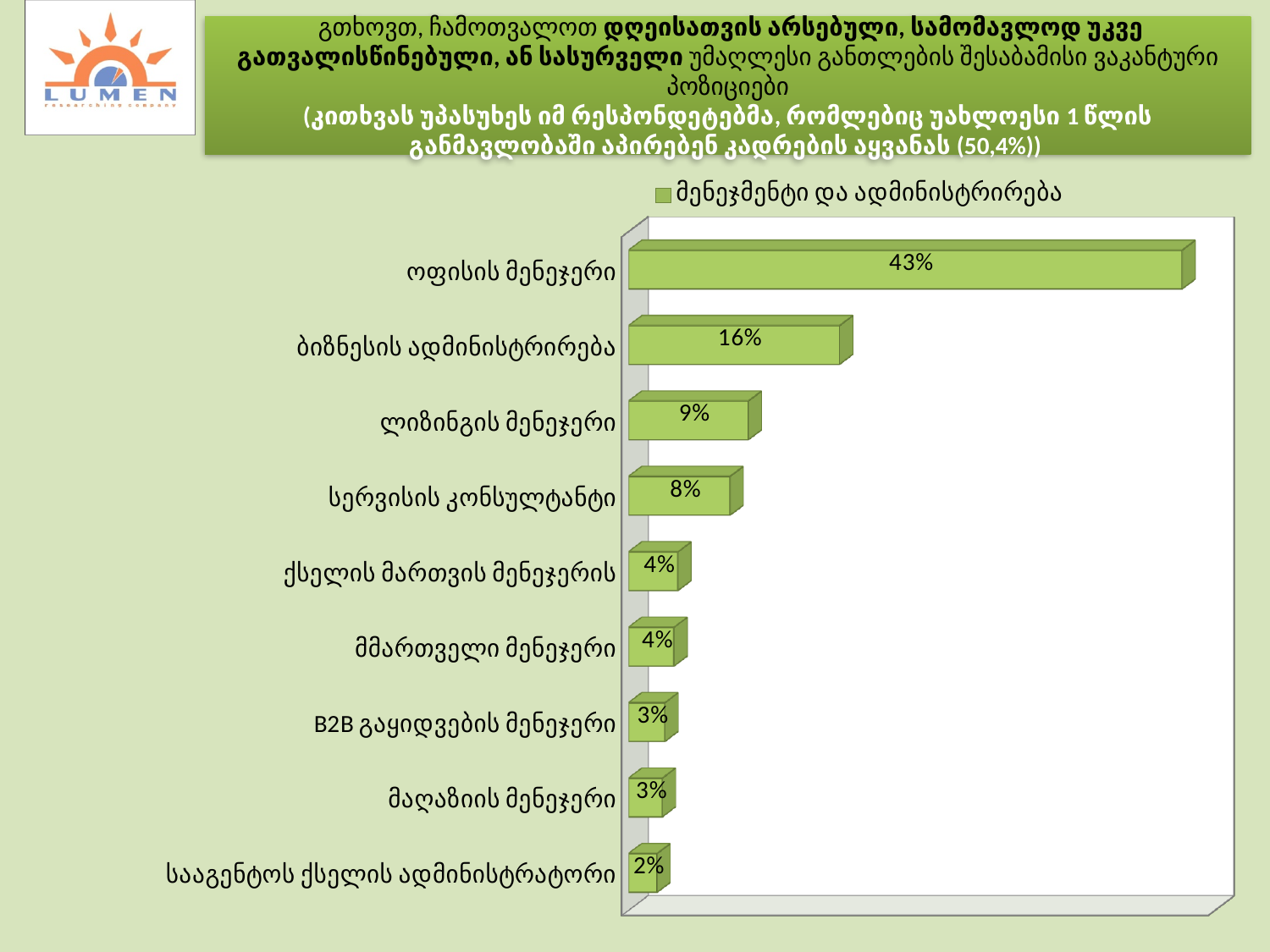
What is the value for სერვისის კონსულტანტი? 8% What is the difference between the values for ოფისის მენეჯერი and ბიზნესის ადმინისტრირება? 27% What is the value for ოფისის მენეჯერი? 43% Which category has the highest value? ოფისის მენეჯერი What is the legend entry of the chart? მენეჯმენტი და ადმინისტრირება What is the value for სააგენტოს ქსელის ადმინისტრატორი? 2% Which is larger, the value for ლიზინგის მენეჯერი or the value for სერვისის კონსულტანტი? ლიზინგის მენეჯერი How many series does the legend list? 1 How many categories are shown in the chart? 9 What is the value for ბიზნესის ადმინისტრირება? 16% What kind of chart is shown on the slide? bar chart Which category has the lowest value? სააგენტოს ქსელის ადმინისტრატორი